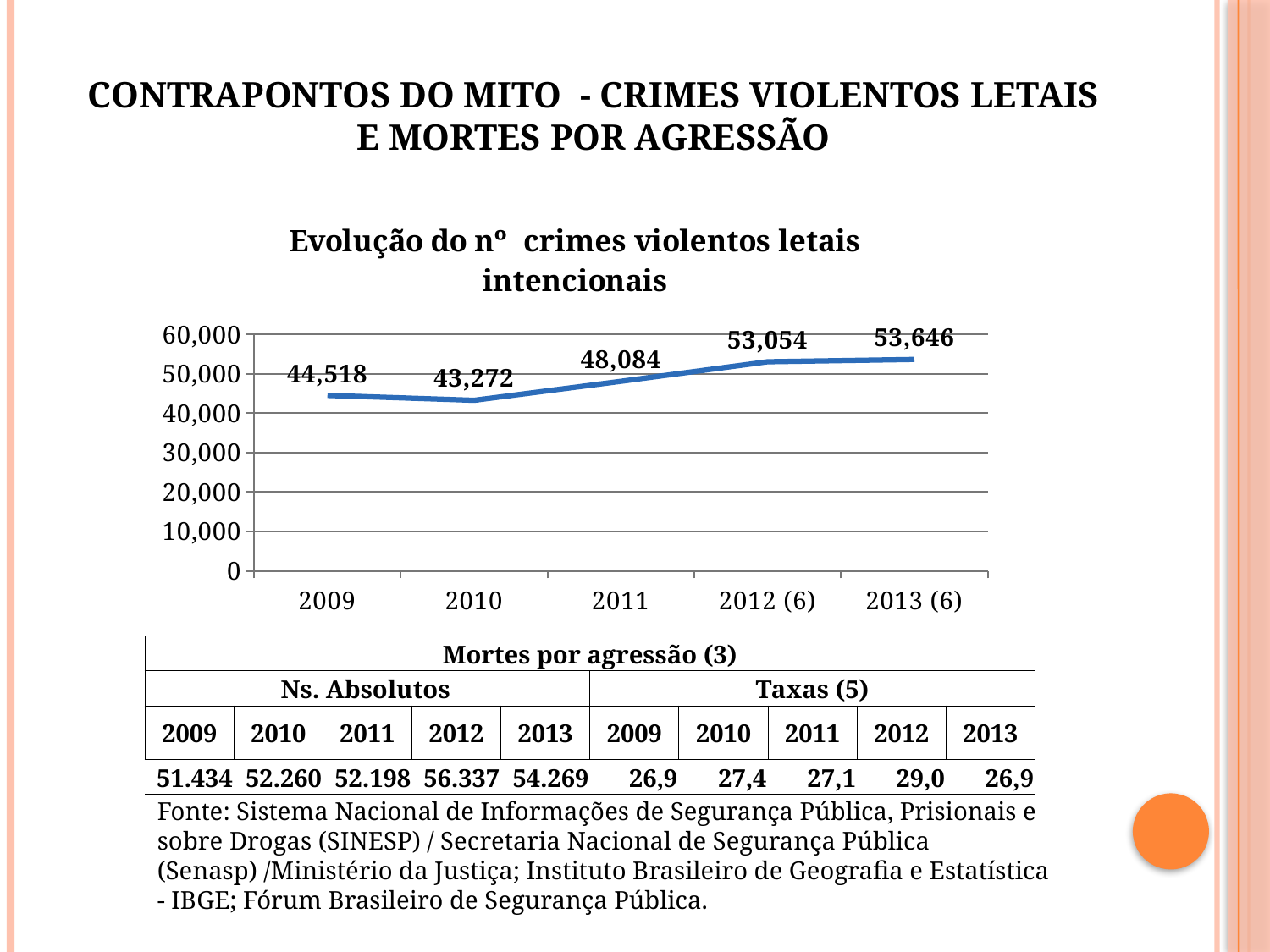
How many data points are plotted on the line? 5 What type of chart is shown on the slide? Line chart Which year has the highest value in the chart? 2013 (6) What is the difference between the values for 2012 (6) and 2011? 4,970 What is the value for 2013 (6) in the chart? 53,646 Which year has the lowest value in the chart? 2010 What is the value for 2011 in the chart? 48,084 What is the title of the chart? Evolução do nº crimes violentos letais intencionais What is the value for 2009 in the chart? 44,518 Does the line generally rise or fall from 2010 to 2013 (6)? Rise Which is larger, the value for 2009 or the value for 2010? 2009 What is the value for 2010 in the chart? 43,272